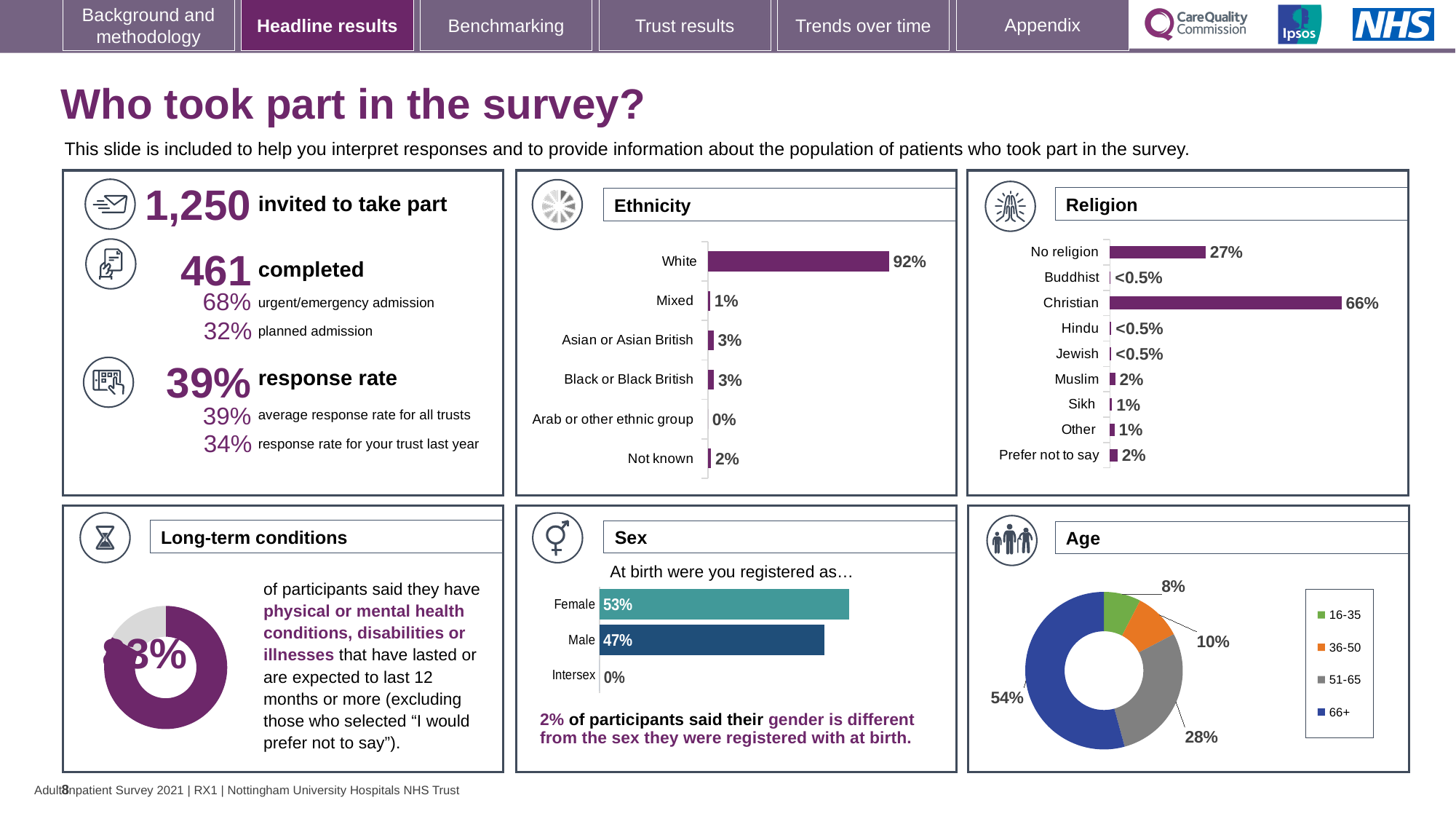
In the Ethnicity chart, which category has the highest value? White In the Age chart, what share of participants were aged 66+? 54% In the Religion chart, what is the difference between the values for Christian and No religion? 39% How many age groups does the legend of the Age chart list? 4 In the Ethnicity chart, what is the difference between the values for White and Asian or Asian British? 89% In the Religion chart, what percentage of participants were Christian? 66% What kind of chart is the Age chart? Doughnut chart How many categories are shown in the Ethnicity chart? 6 In the Ethnicity chart, what percentage of participants were White? 92% In the Sex chart, what percentage of participants were registered as Female at birth? 53% How many categories are shown in the Religion chart? 9 In the Religion chart, which is larger, the value for No religion or the value for Muslim? No religion